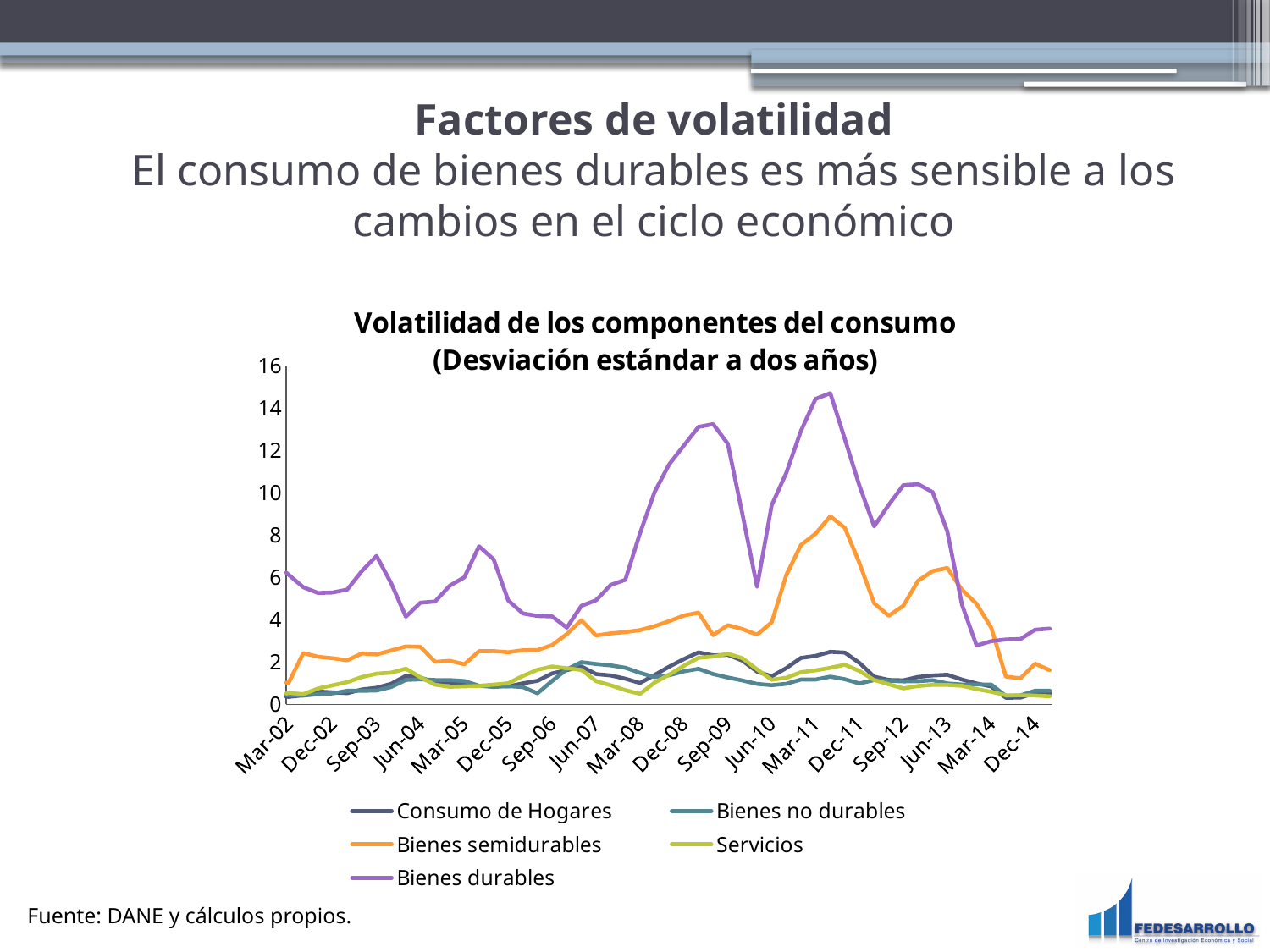
Which series reaches the highest value on the chart? Bienes durables Is the value for Servicios at Dec-14 greater or less than 2? less Is the value for Bienes semidurables at Mar-11 greater or less than 6? greater How many date labels are shown on the x axis? 18 Is the value for Bienes durables at Jun-10 greater or less than 8? greater At Dec-08, which is larger: Bienes durables or Bienes semidurables? Bienes durables How many series does the legend list? 5 Does the Bienes durables series rise or fall between Jun-13 and Mar-14? fall What is the title of the chart? Volatilidad de los componentes del consumo (Desviación estándar a dos años) What kind of chart is shown on the slide? Line chart